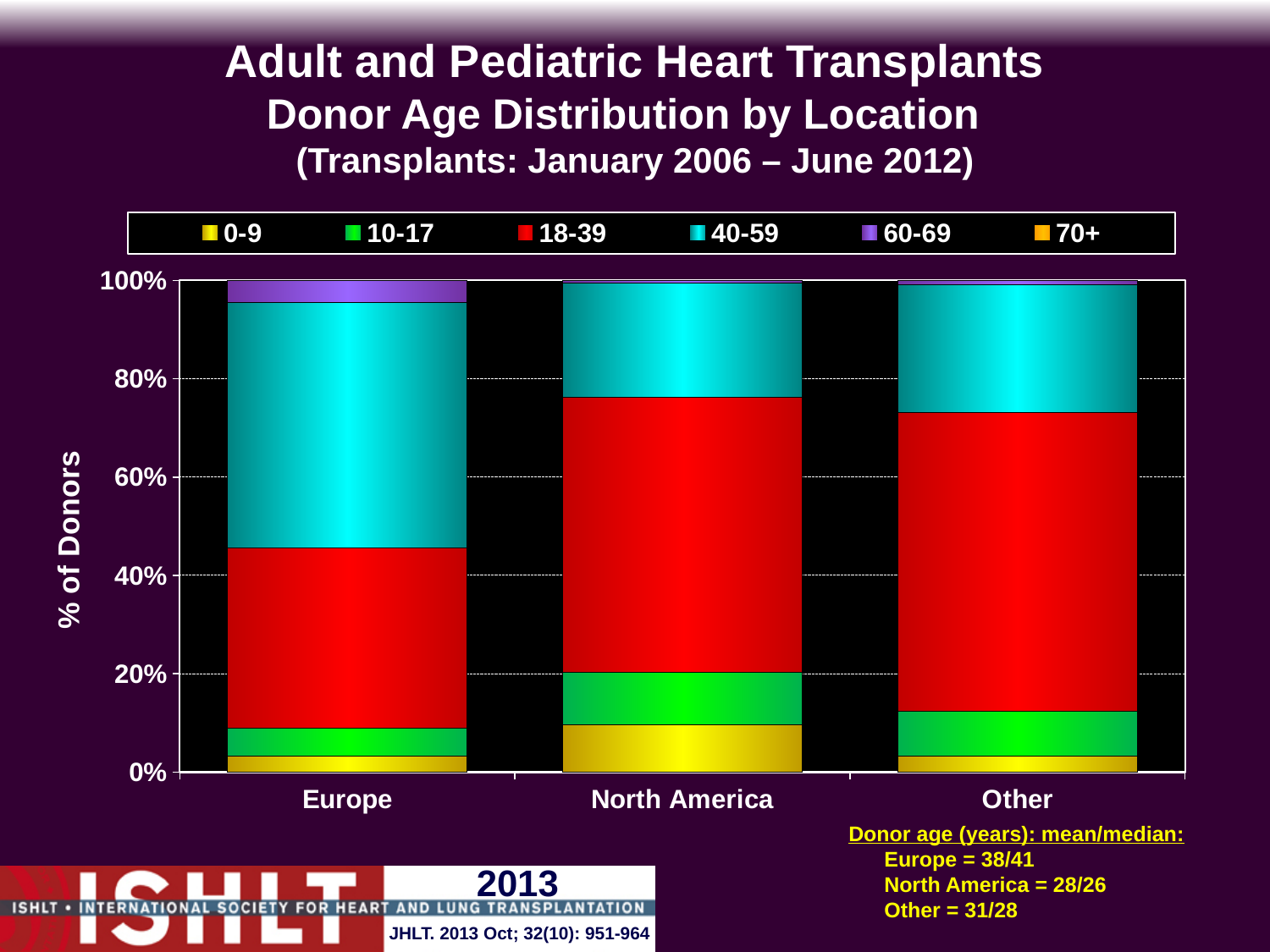
How many donor age groups does the legend list? 6 Which donor age group is shown in red in the chart? 18-39 Is the share of donors aged 40-59 in North America greater or less than 40%? less Which location has the larger share of donors aged 0-9, Europe or North America? North America Is the share of donors aged 40-59 in Europe greater or less than 40%? greater Is the share of donors aged 18-39 in North America greater or less than 40%? greater Which location has the larger share of donors aged 18-39, Europe or North America? North America Which location has the largest share of donors aged 40-59? Europe What kind of chart is shown on the slide? Stacked bar chart How many locations are shown on the x axis of the chart? 3 What is the label of the y axis? % of Donors